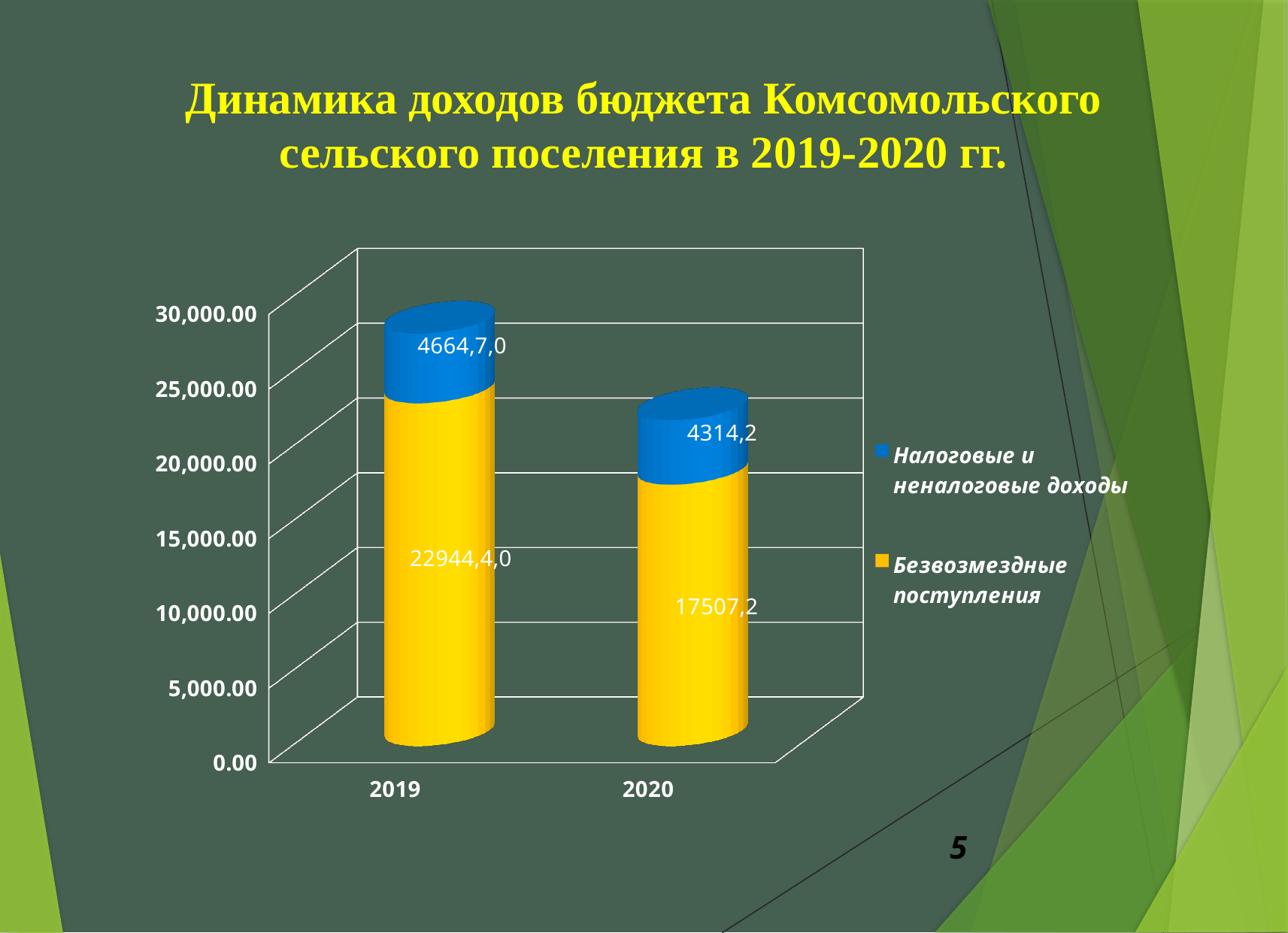
How many series does the legend list? 2 What data label is shown for Налоговые и неналоговые доходы in 2019? 4664,7,0 How many years are shown on the x axis? 2 Which year has the taller stacked bar? 2019 What is the total of the stacked bar for 2020? 21821,4 Which is larger in 2020: Безвозмездные поступления or Налоговые и неналоговые доходы? Безвозмездные поступления What data label is shown for Безвозмездные поступления in 2019? 22944,4,0 Which colour represents Налоговые и неналоговые доходы in the legend? blue What is the value of Безвозмездные поступления for 2020? 17507,2 What is the value of Налоговые и неналоговые доходы for 2020? 4314,2 Is the total stacked bar for 2019 greater or less than 25,000.00? greater What type of chart is shown on the slide? bar chart